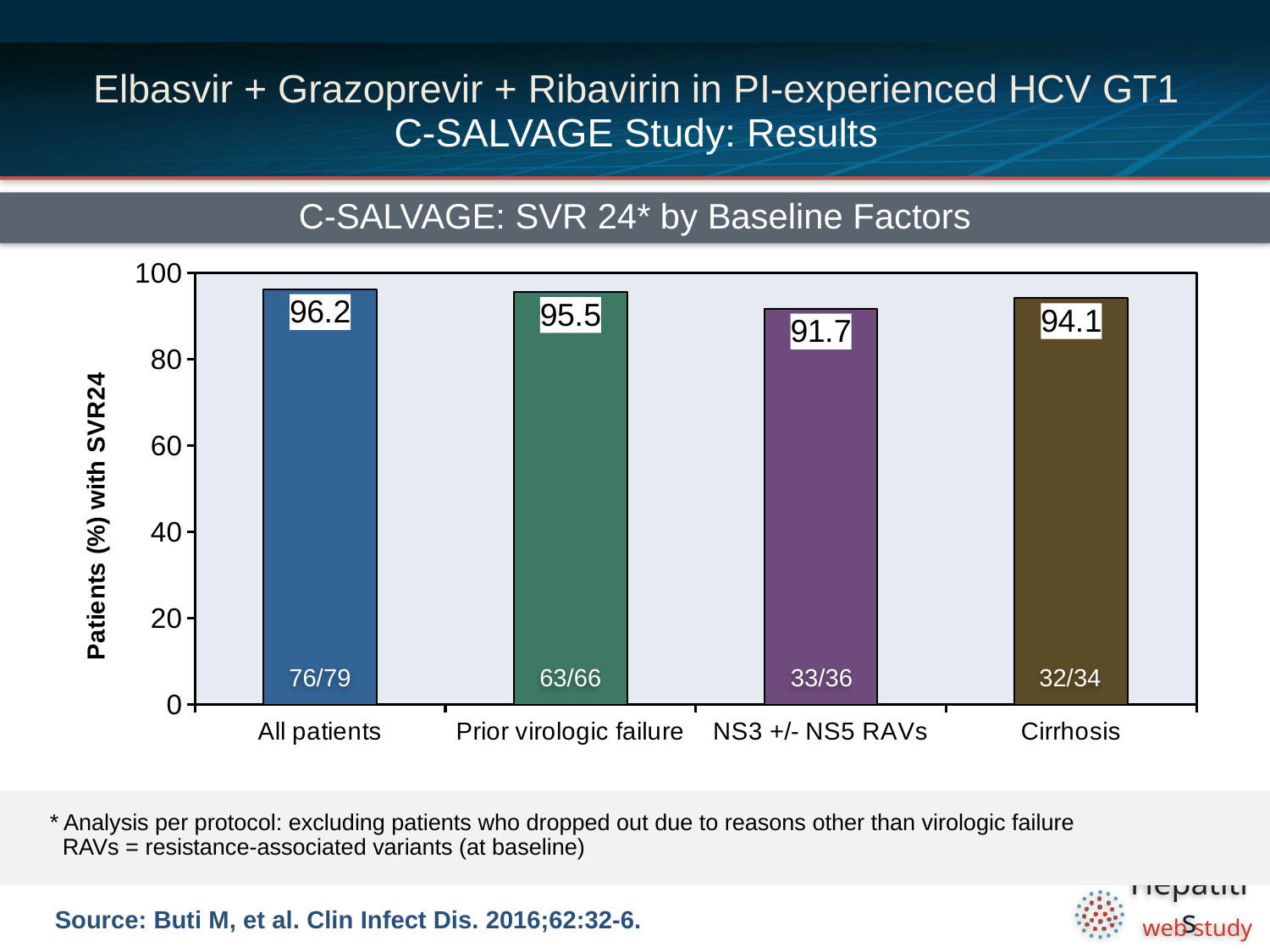
What fraction of patients is shown inside the All patients bar? 76/79 What is the SVR24 rate for patients with NS3 +/- NS5 RAVs? 91.7 What is the SVR24 rate for All patients? 96.2 Which category has the highest SVR24 rate? All patients What fraction of patients is shown inside the Cirrhosis bar? 32/34 Which is larger, the SVR24 rate for Cirrhosis or for NS3 +/- NS5 RAVs? Cirrhosis How many categories are shown on the x axis? 4 What is the SVR24 rate for patients with Prior virologic failure? 95.5 What is the difference between the SVR24 rate for All patients and for NS3 +/- NS5 RAVs? 4.5 Which category has the lowest SVR24 rate? NS3 +/- NS5 RAVs What is the SVR24 rate for patients with Cirrhosis? 94.1 What kind of chart is shown on the slide? Bar chart